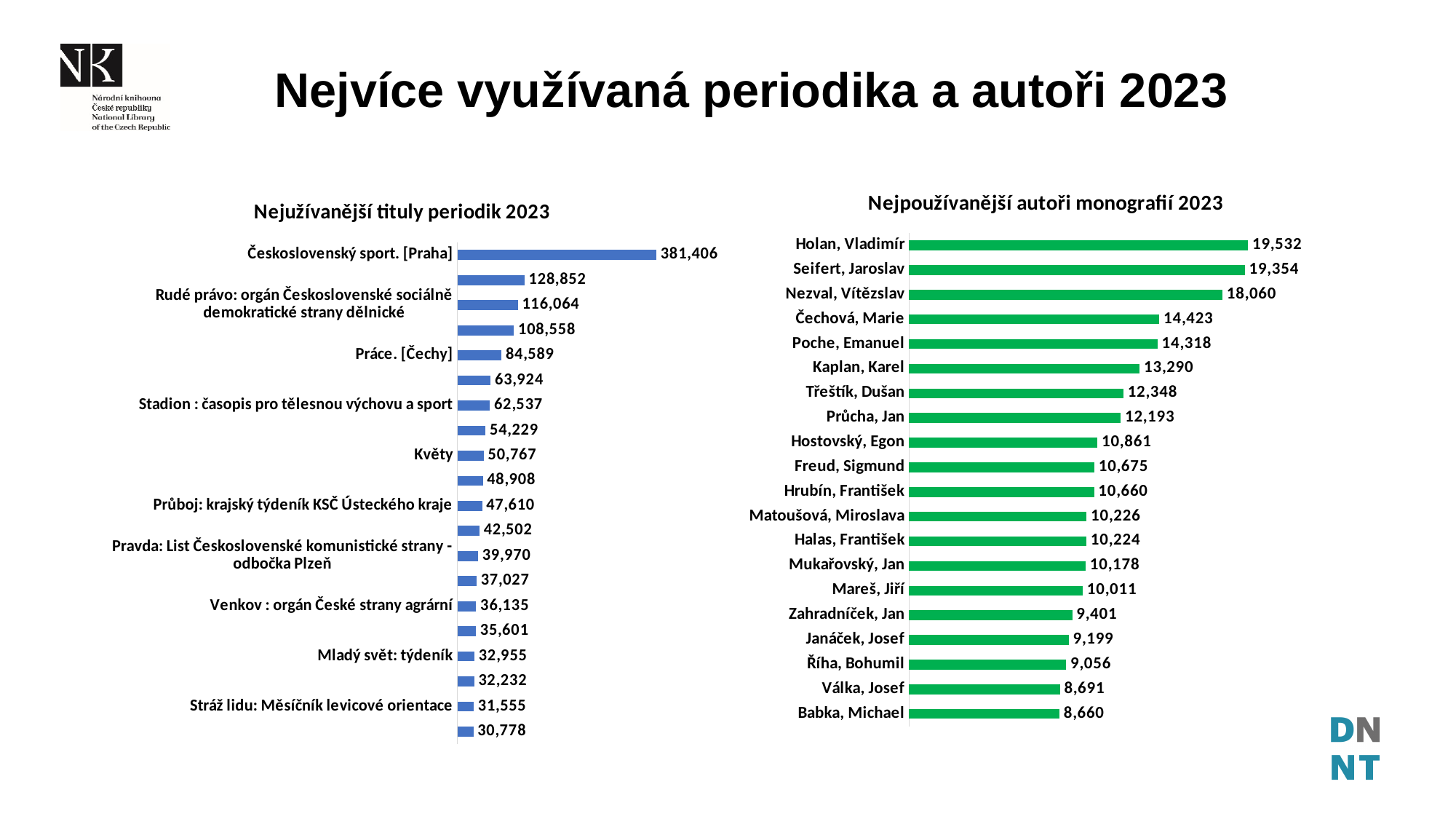
In the chart 'Nejpoužívanější autoři monografií 2023', which is larger: Čechová, Marie or Třeštík, Dušan? Čechová, Marie In the chart 'Nejpoužívanější autoři monografií 2023', what is the value for Kaplan, Karel? 13,290 In the chart 'Nejužívanější tituly periodik 2023', what is the value for Československý sport. [Praha]? 381,406 In the chart 'Nejpoužívanější autoři monografií 2023', what is the difference between Holan, Vladimír and Seifert, Jaroslav? 178 In the chart 'Nejužívanější tituly periodik 2023', what is the value for Mladý svět: týdeník? 32,955 In the chart 'Nejužívanější tituly periodik 2023', how many bars are plotted? 20 In the chart 'Nejužívanější tituly periodik 2023', what is the value for Květy? 50,767 In the chart 'Nejužívanější tituly periodik 2023', what is the difference between Práce. [Čechy] and Stadion : časopis pro tělesnou výchovu a sport? 22,052 In the chart 'Nejpoužívanější autoři monografií 2023', how many authors are listed? 20 In the chart 'Nejpoužívanější autoři monografií 2023', which author has the lowest value? Babka, Michael In the chart 'Nejpoužívanější autoři monografií 2023', which author has the highest value? Holan, Vladimír What type of chart is 'Nejpoužívanější autoři monografií 2023'? Bar chart